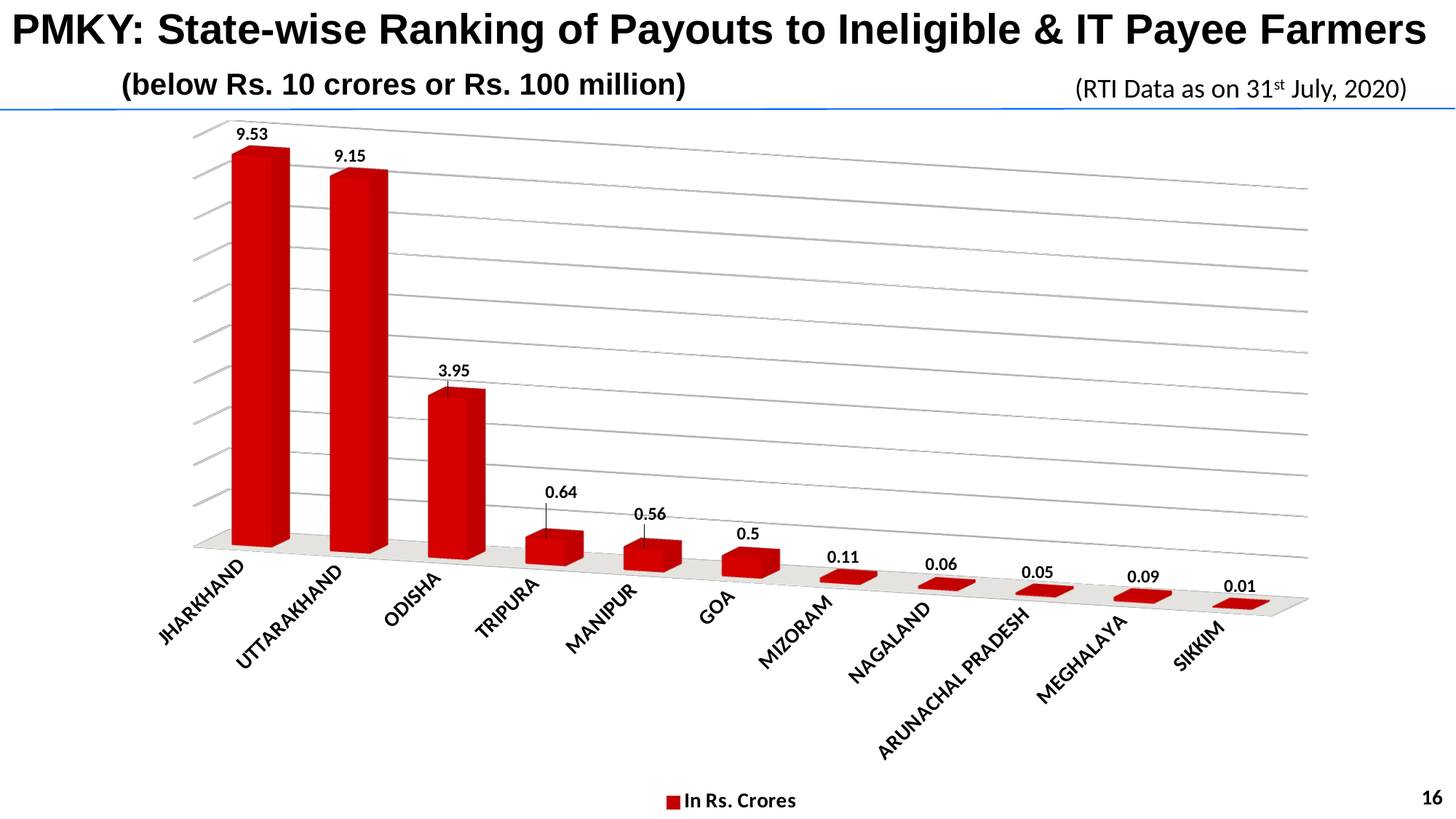
What is the value for Jharkhand? 9.53 What is the value for Meghalaya? 0.09 What kind of chart is shown on the slide? Bar chart How many states are shown in the chart? 11 What is the difference between the values for Jharkhand and Uttarakhand? 0.38 Which has a larger value, Tripura or Manipur? Tripura How many series does the legend list? 1 What is the legend entry for the series in the chart? In Rs. Crores Which state has the highest value? Jharkhand What is the value for Goa? 0.5 What is the value for Odisha? 3.95 Which state has the lowest value? Sikkim